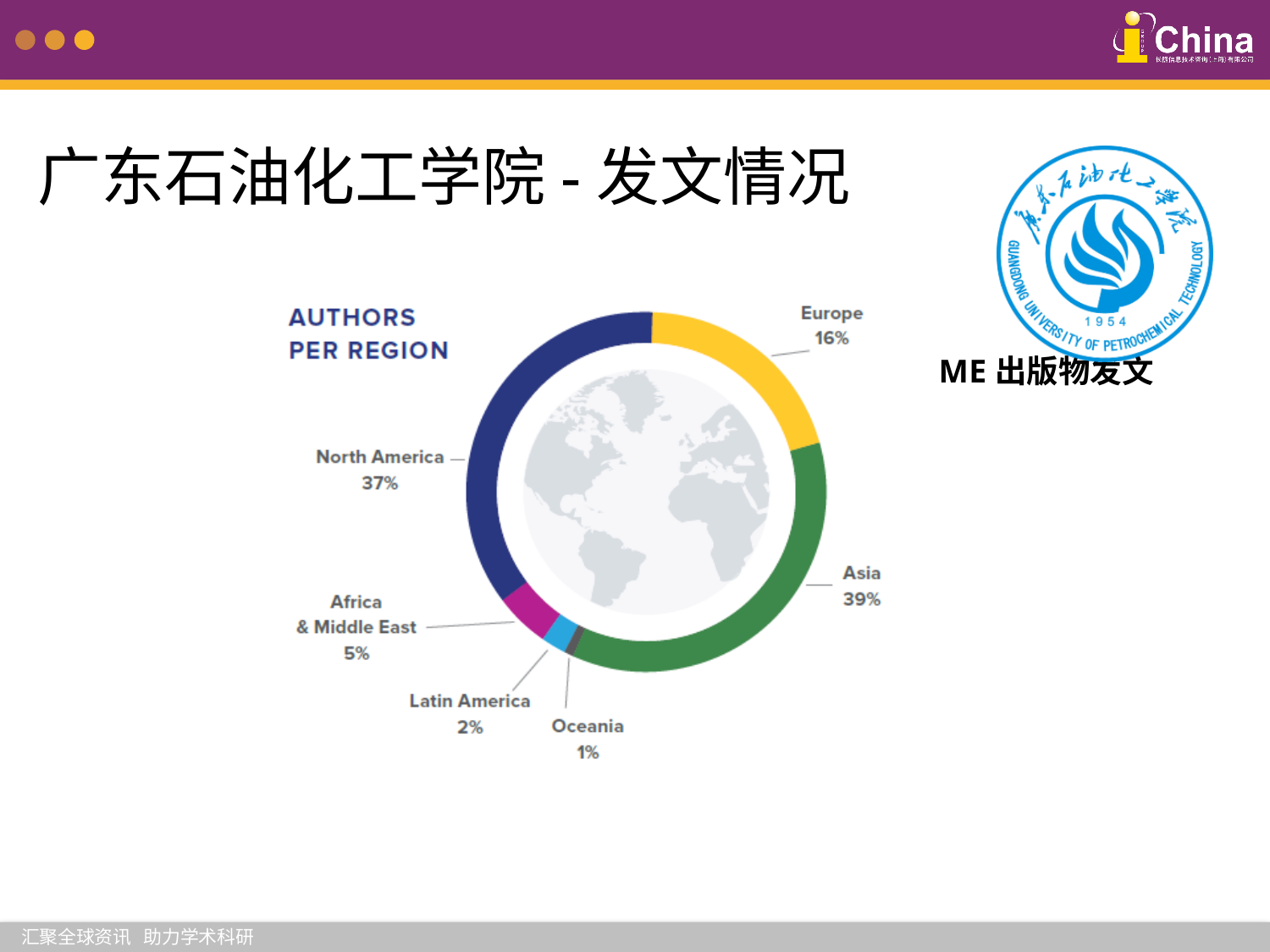
What share of authors is from Asia in the Authors per Region chart? 39% Which region has the smallest share of authors? Oceania What share of authors is from North America? 37% How many regions are shown in the Authors per Region chart? 6 What share of authors is from Oceania? 1% What is the difference in percentage points between Asia and Europe? 23 Which region has the largest share of authors? Asia What share of authors is from Europe? 16% What is the title of the chart on the slide? AUTHORS PER REGION What kind of chart is used to show authors per region? Pie chart (donut) Which has a larger share of authors, North America or Europe? North America What share of authors is from Africa & Middle East? 5%